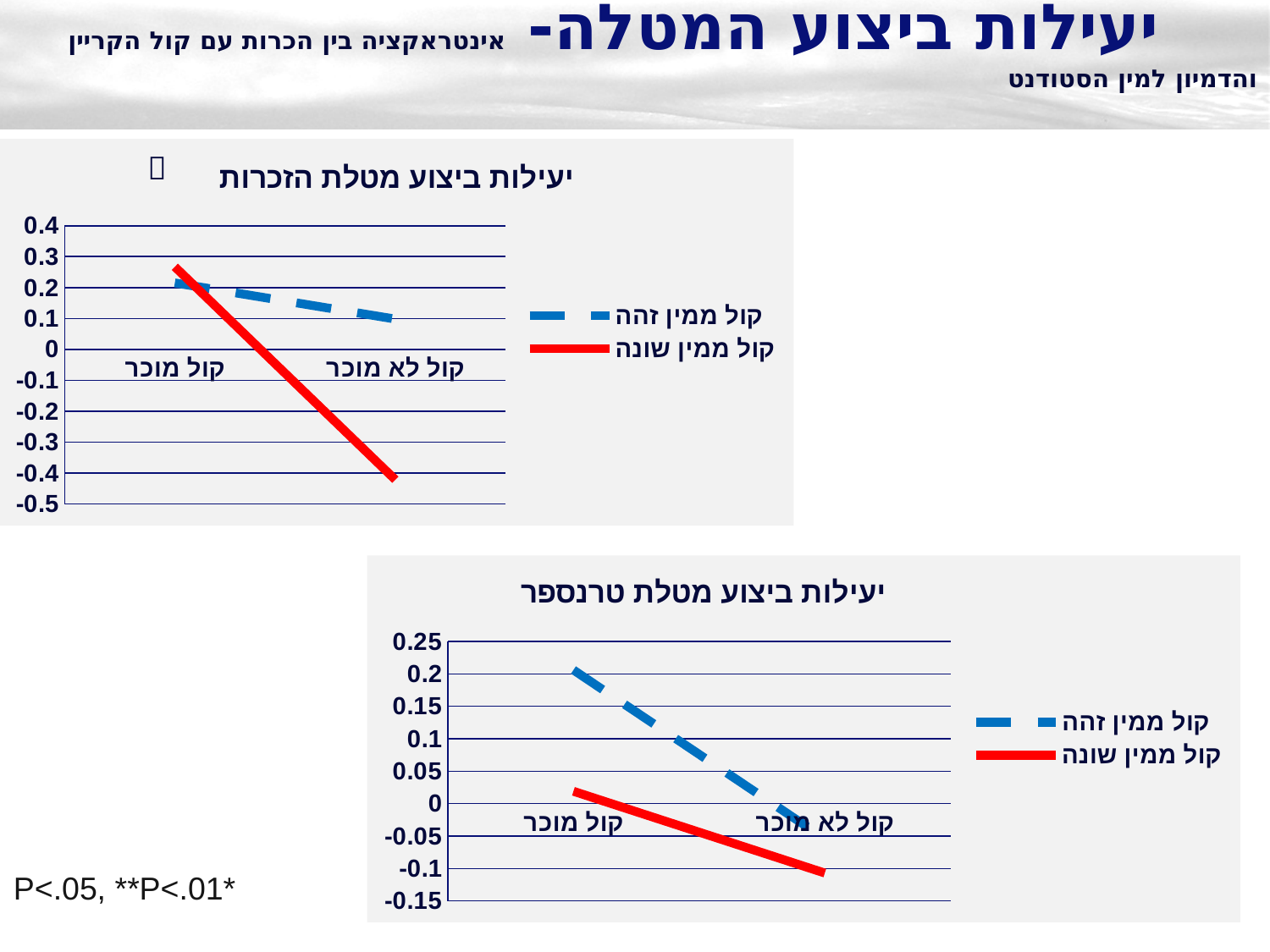
In the bottom chart ('יעילות ביצוע מטלת טרנספר'), which series has the higher value at 'קול מוכר', 'קול ממין זהה' or 'קול ממין שונה'? קול ממין זהה In the top chart ('יעילות ביצוע מטלת הזכרות'), is the value of 'קול ממין שונה' at 'קול לא מוכר' greater or less than -0.3? less In the bottom chart ('יעילות ביצוע מטלת טרנספר'), which series is drawn as a solid red line? קול ממין שונה In the top chart ('יעילות ביצוע מטלת הזכרות'), is the value of 'קול ממין זהה' at 'קול מוכר' greater or less than 0.1? greater In the bottom chart ('יעילות ביצוע מטלת טרנספר'), is the value of 'קול ממין שונה' at 'קול לא מוכר' greater or less than -0.05? less In the top chart ('יעילות ביצוע מטלת הזכרות'), does the 'קול ממין שונה' line rise or fall from 'קול מוכר' to 'קול לא מוכר'? Fall How many categories are shown on the x axis of the bottom chart ('יעילות ביצוע מטלת טרנספר')? 2 How many series does the legend of the top chart ('יעילות ביצוע מטלת הזכרות') list? 2 What type of chart is the top chart titled 'יעילות ביצוע מטלת הזכרות'? Line chart In the top chart ('יעילות ביצוע מטלת הזכרות'), which series has the higher value at 'קול לא מוכר', 'קול ממין זהה' or 'קול ממין שונה'? קול ממין זהה In the bottom chart ('יעילות ביצוע מטלת טרנספר'), does the 'קול ממין זהה' line rise or fall from 'קול מוכר' to 'קול לא מוכר'? Fall